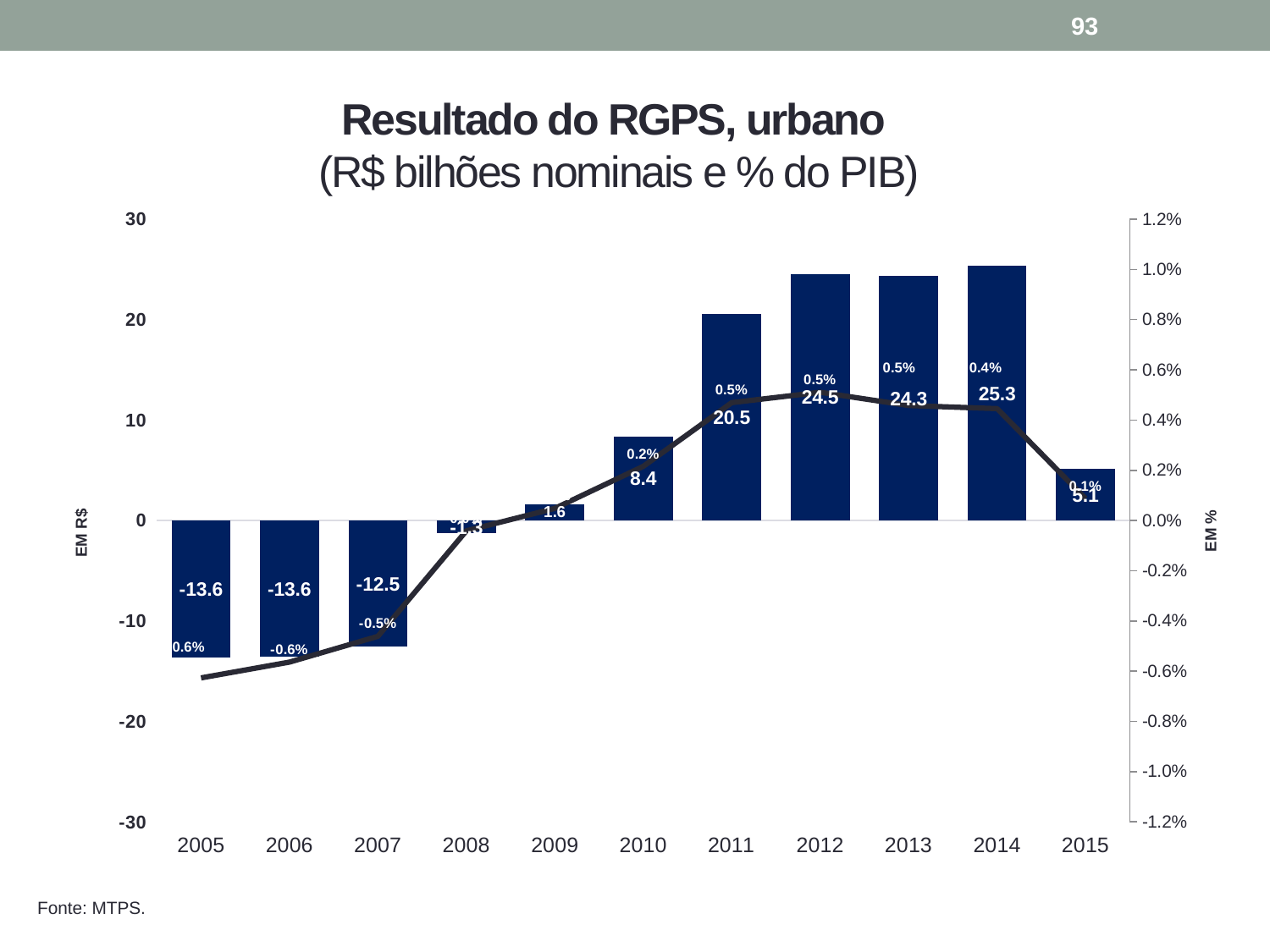
What is the title of the chart? Resultado do RGPS, urbano What is the value in R$ billions for 2011? 20.5 Is the bar value for 2010 greater or less than 10? less What is the value in R$ billions for 2014? 25.3 Which is larger in R$ billions, 2012 or 2015? 2012 How many years are shown on the x axis? 11 What is the difference in R$ billions between 2014 and 2015? 20.2 What is the % do PIB value shown for 2010? 0.2% What is the label of the right-hand vertical axis? EM % What is the % do PIB value shown for 2014? 0.4% Which year has the highest bar value in R$ billions? 2014 What is the value in R$ billions for 2007? -12.5